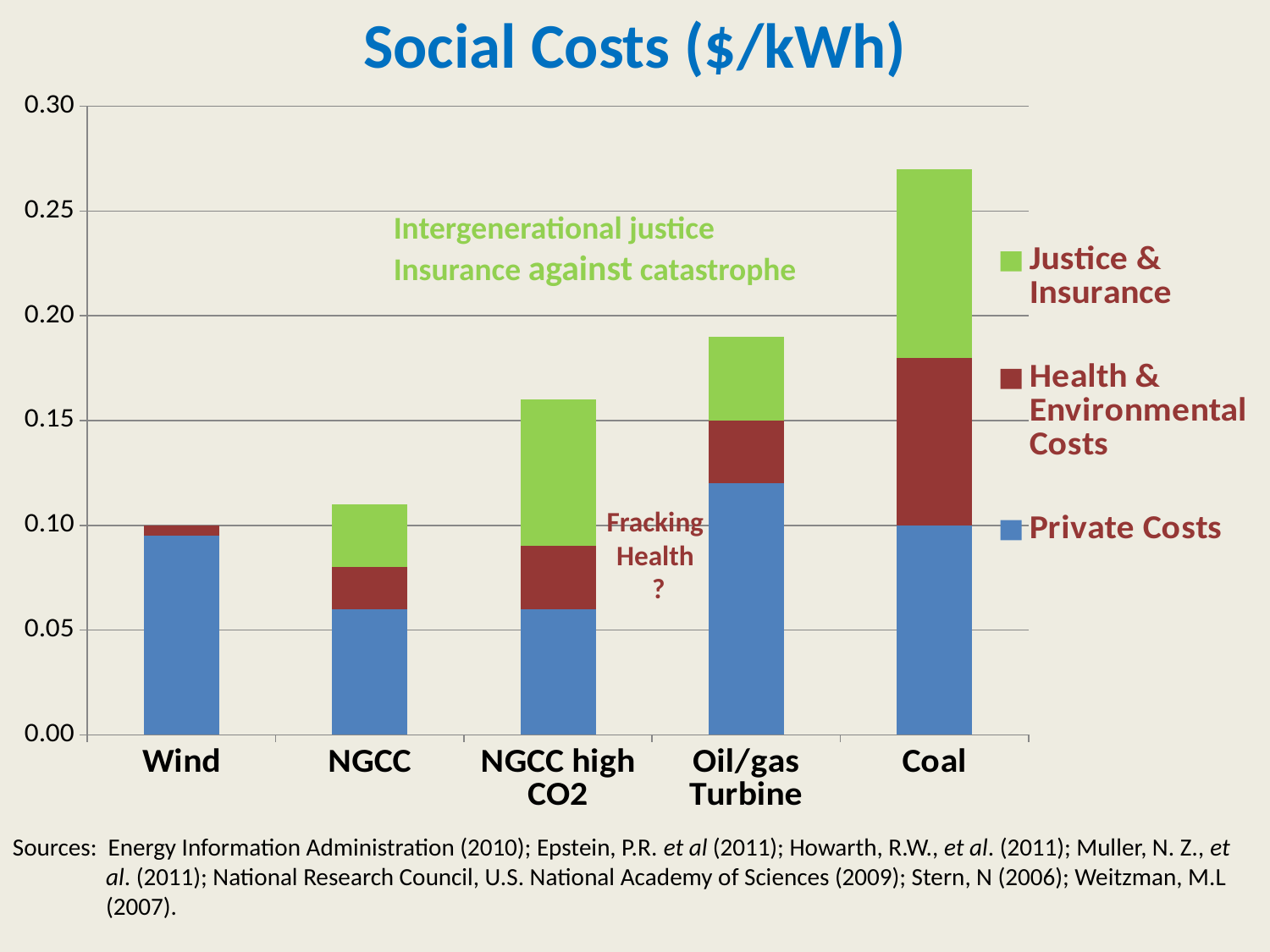
Which category has the highest total social cost? Coal Which has a larger total social cost, Coal or Wind? Coal How many energy source categories are shown on the x axis? 5 Is the total social cost for Coal greater or less than 0.25? greater What is the Private Costs value for Coal in $/kWh? 0.10 Which category has the lowest total social cost? Wind What kind of chart is shown on the slide? Stacked bar chart How many series does the legend list? 3 Do the total social costs rise or fall moving from Wind to Coal along the x axis? Rise What is the total social cost for Wind in $/kWh? 0.10 What is the title of the chart? Social Costs ($/kWh) Is the total social cost for Oil/gas Turbine greater or less than 0.20? less